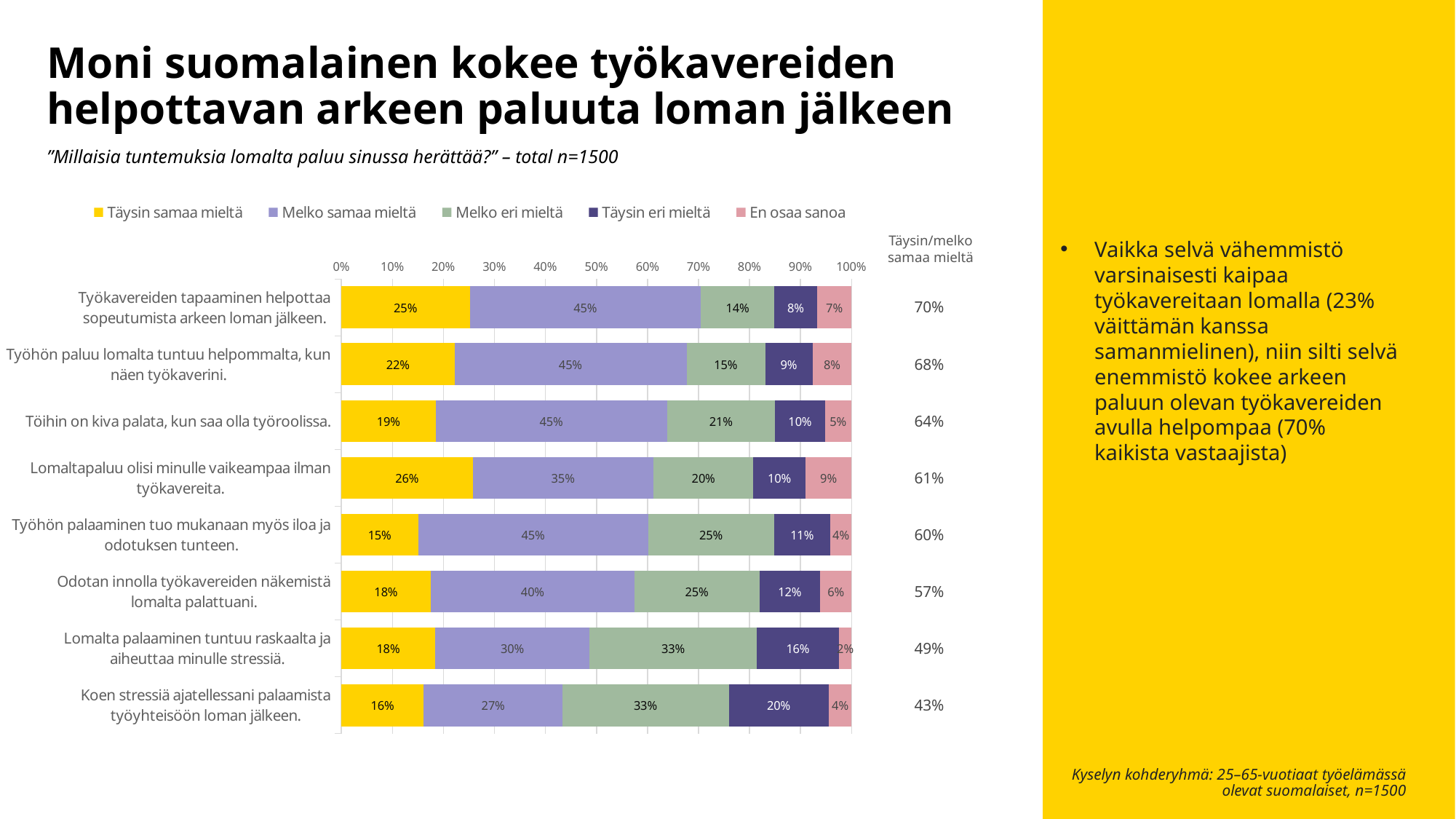
Which statement has the highest 'Täysin samaa mieltä' share? Lomaltapaluu olisi minulle vaikeampaa ilman työkavereita. Which legend entry is shown in yellow? Täysin samaa mieltä What kind of chart is shown on the slide? Stacked bar chart What is the 'Täysin eri mieltä' value for 'Koen stressiä ajatellessani palaamista työyhteisöön loman jälkeen.'? 20% Which statement has the lowest 'Täysin eri mieltä' share? Työkavereiden tapaaminen helpottaa sopeutumista arkeen loman jälkeen. What is the 'Täysin samaa mieltä' value for 'Töihin on kiva palata, kun saa olla työroolissa.'? 19% What is the 'Melko eri mieltä' value for 'Lomalta palaaminen tuntuu raskaalta ja aiheuttaa minulle stressiä.'? 33% What is the difference between the 'Melko samaa mieltä' values for 'Odotan innolla työkavereiden näkemistä lomalta palattuani.' and 'Koen stressiä ajatellessani palaamista työyhteisöön loman jälkeen.'? 13% Which is larger: the 'En osaa sanoa' value for 'Lomaltapaluu olisi minulle vaikeampaa ilman työkavereita.' or for 'Työhön palaaminen tuo mukanaan myös iloa ja odotuksen tunteen.'? Lomaltapaluu olisi minulle vaikeampaa ilman työkavereita. How many series does the legend list? 5 How many statements (categories) are plotted in the chart? 8 What is the combined 'Täysin/melko samaa mieltä' share shown for 'Työhön paluu lomalta tuntuu helpommalta, kun näen työkaverini.'? 68%